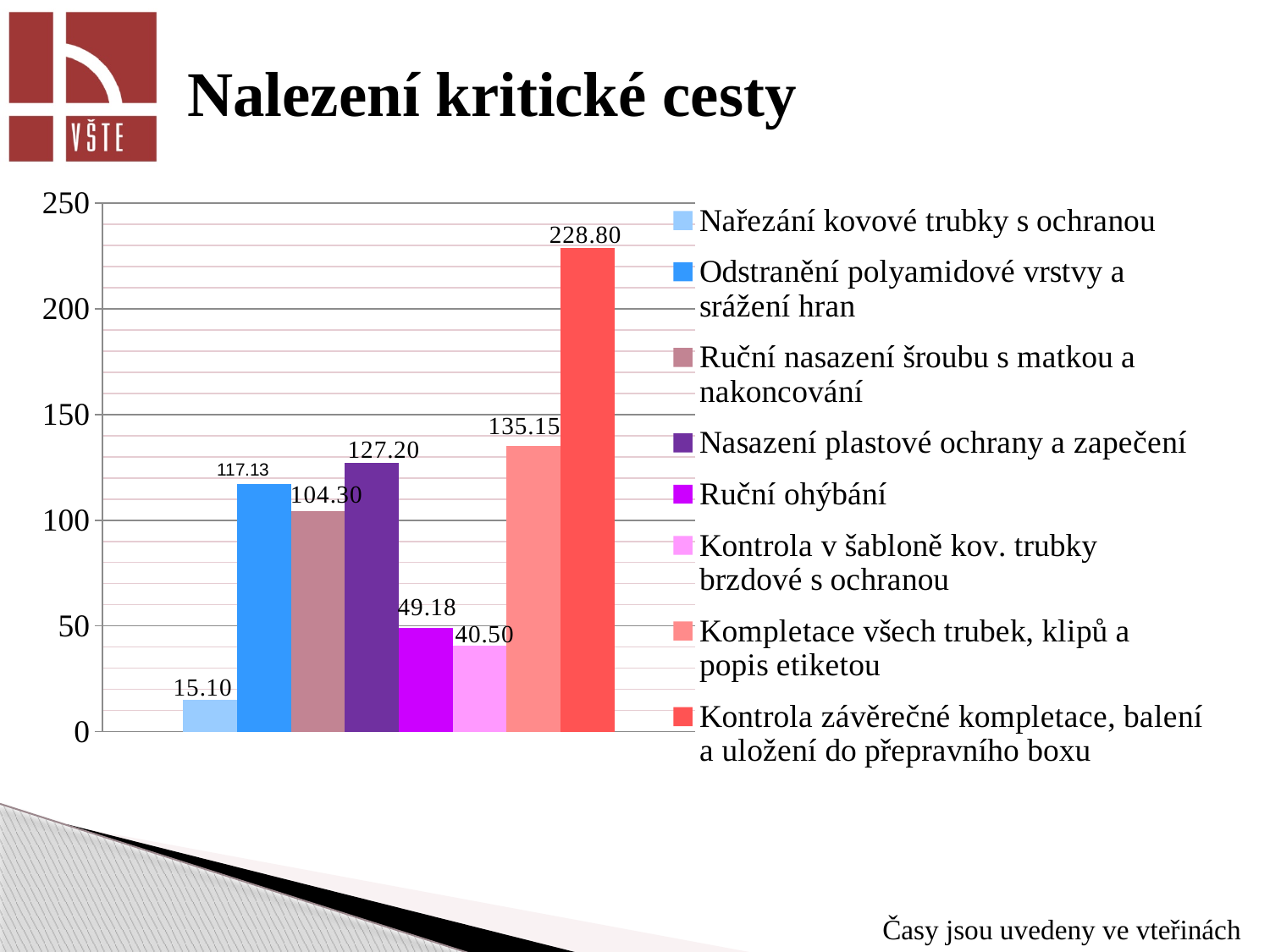
Which series has the highest value? Kontrola závěrečné kompletace, balení a uložení do přepravního boxu Is the value for Kontrola v šabloně kov. trubky brzdové s ochranou greater or less than 50? less What is the title of the slide containing the chart? Nalezení kritické cesty How many series does the legend list? 8 What is the difference between the values for Nasazení plastové ochrany a zapečení and Ruční nasazení šroubu s matkou a nakoncování? 22.90 Which series has the lowest value? Nařezání kovové trubky s ochranou What is the value for Nařezání kovové trubky s ochranou? 15.10 What is the value for Ruční ohýbání? 49.18 What is the value for Kompletace všech trubek, klipů a popis etiketou? 135.15 What is the value for Kontrola závěrečné kompletace, balení a uložení do přepravního boxu? 228.80 Which is larger: the value for Odstranění polyamidové vrstvy a srážení hran or the value for Nasazení plastové ochrany a zapečení? Nasazení plastové ochrany a zapečení What kind of chart is shown on the slide? bar chart